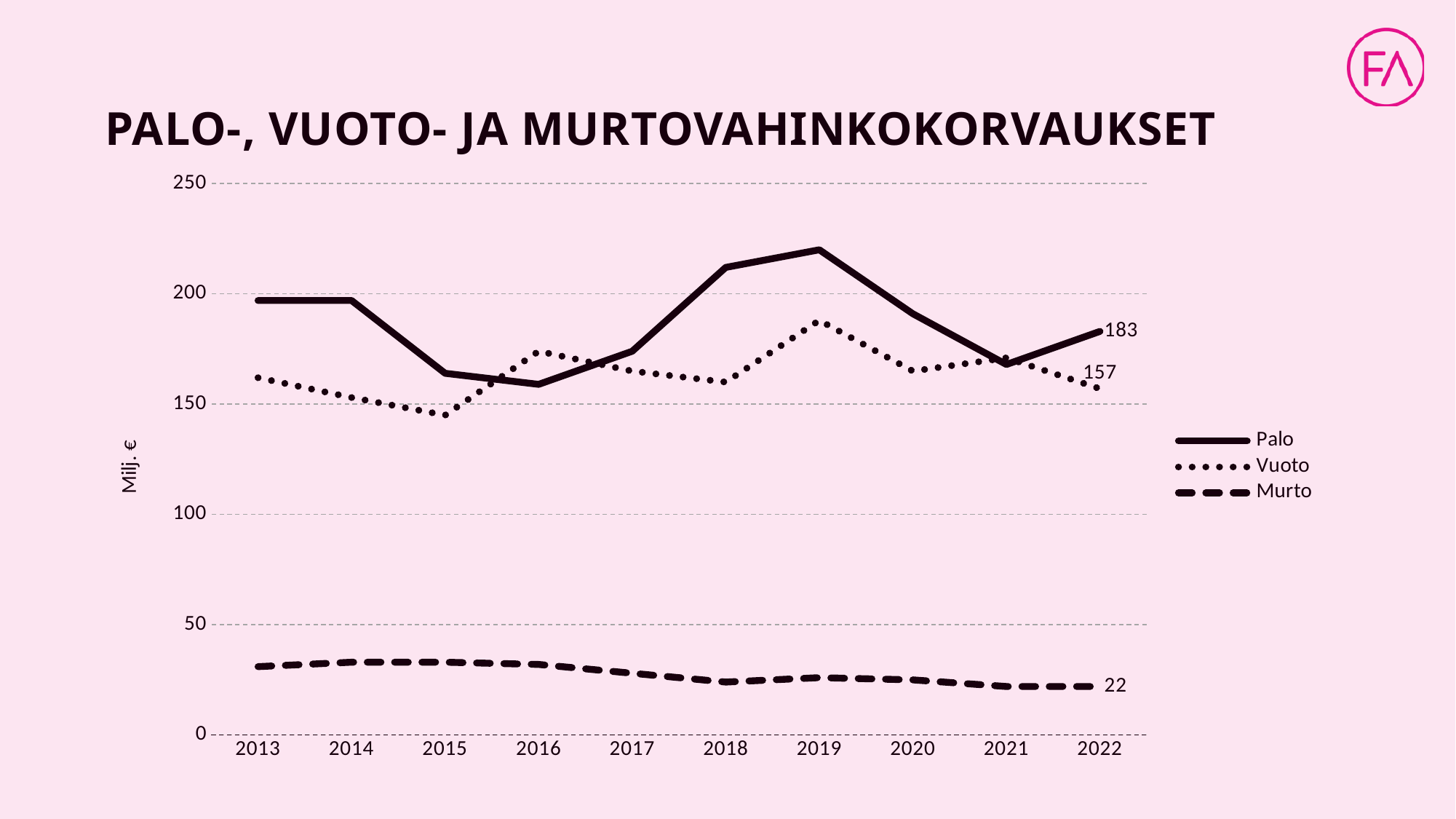
What is the value for Vuoto in 2022? 157 What kind of chart is shown on the slide? Line chart What is the value for Palo in 2022? 183 In which year does the Palo line reach its highest value? 2019 How many years are shown on the x axis? 10 Is the value for Murto in 2013 greater or less than 50? less What is the value for Murto in 2022? 22 Is the value for Palo in 2019 greater or less than 200? greater What is the difference between the Palo and Vuoto values in 2022? 26 Which series has the larger value in 2022, Palo or Murto? Palo In which year does the Vuoto line reach its lowest value? 2015 How many series does the legend list? 3